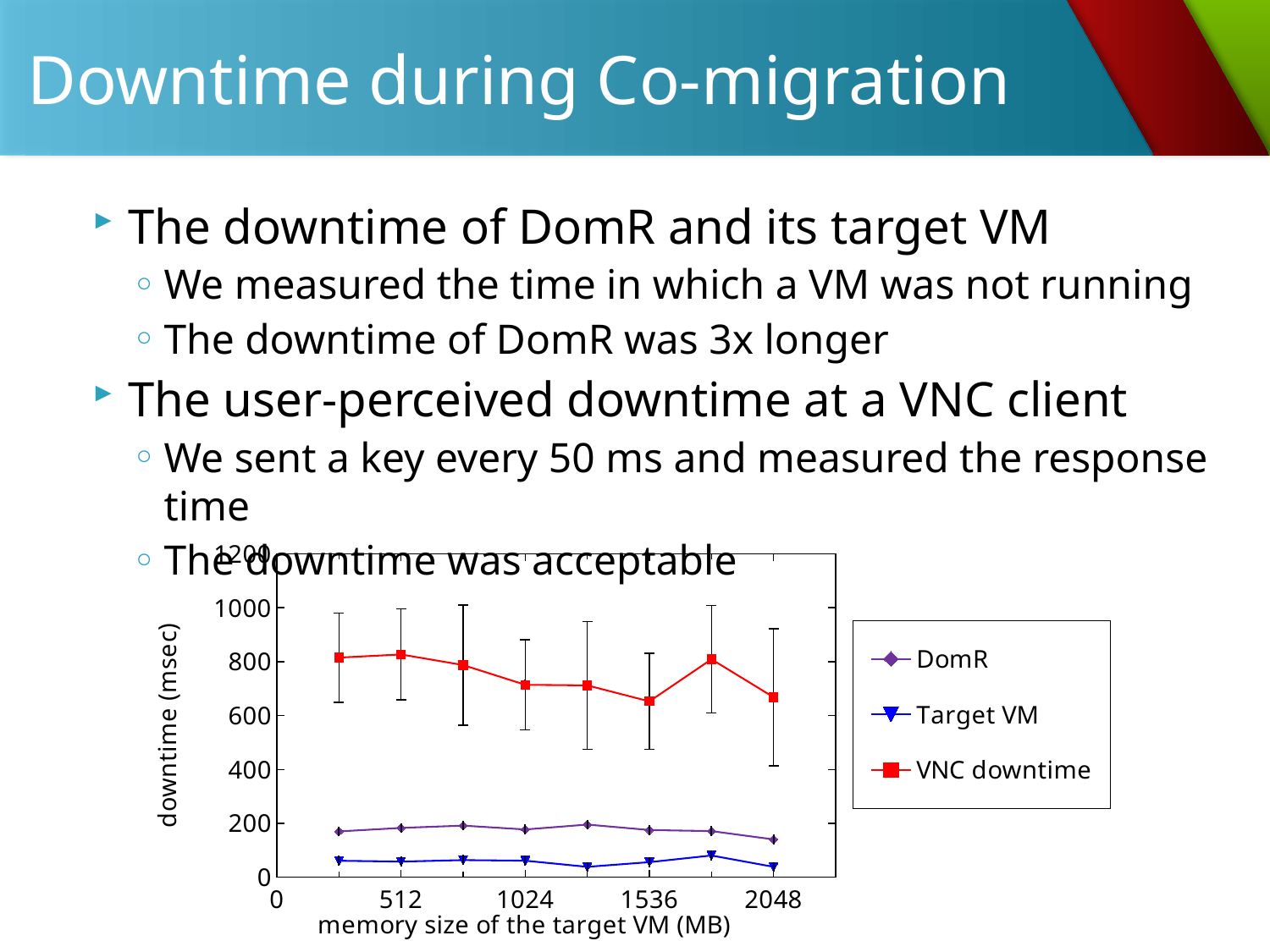
Which series has the highest downtime values across all memory sizes? VNC downtime At a memory size of 1024 MB, which is larger: the DomR downtime or the VNC downtime? VNC downtime Is the DomR downtime at a memory size of 2048 MB greater or less than 200 msec? less How many series does the legend list? 3 What kind of chart is shown on the slide? line chart How many data points are plotted for the VNC downtime series? 8 Which series has the lowest downtime values across all memory sizes? Target VM Is the VNC downtime at a memory size of 1536 MB greater or less than 800 msec? less What is the label of the y axis? downtime (msec) Does the VNC downtime rise or fall as memory size increases from 512 MB to 1536 MB? fall What is the label of the x axis? memory size of the target VM (MB) Is the Target VM downtime at a memory size of 1024 MB greater or less than 200 msec? less